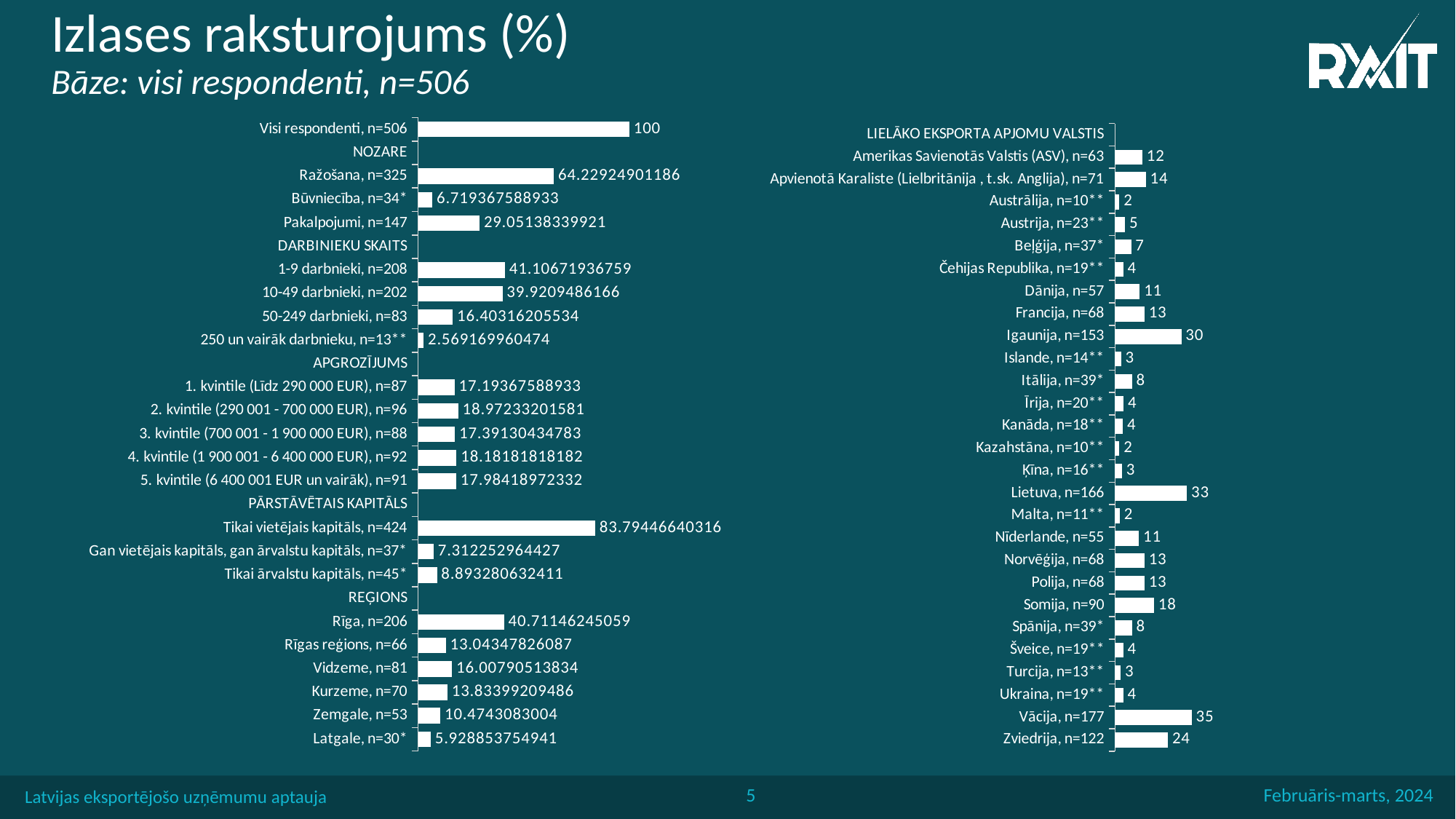
In the left chart, what is the value for Tikai vietējais kapitāls, n=424? 83.79446640316 In the left chart, which is larger: the value for Pakalpojumi, n=147 or the value for Būvniecība, n=34*? Pakalpojumi, n=147 In the left chart, what is the value for Rīga, n=206? 40.71146245059 In the right chart (LIELĀKO EKSPORTA APJOMU VALSTIS), what is the value for Vācija, n=177? 35 In the left chart, what is the value for Ražošana, n=325? 64.22924901186 In the right chart (LIELĀKO EKSPORTA APJOMU VALSTIS), what is the value for Igaunija, n=153? 30 What type of chart is the right chart (LIELĀKO EKSPORTA APJOMU VALSTIS)? Bar chart In the right chart (LIELĀKO EKSPORTA APJOMU VALSTIS), what is the difference between the values for Igaunija, n=153 and Zviedrija, n=122? 6 In the right chart (LIELĀKO EKSPORTA APJOMU VALSTIS), what is the difference between the values for Vācija, n=177 and Lietuva, n=166? 2 In the right chart (LIELĀKO EKSPORTA APJOMU VALSTIS), which country has the highest value? Vācija, n=177 In the right chart (LIELĀKO EKSPORTA APJOMU VALSTIS), how many countries are listed? 27 In the left chart, which region (REĢIONS group) has the lowest value? Latgale, n=30*